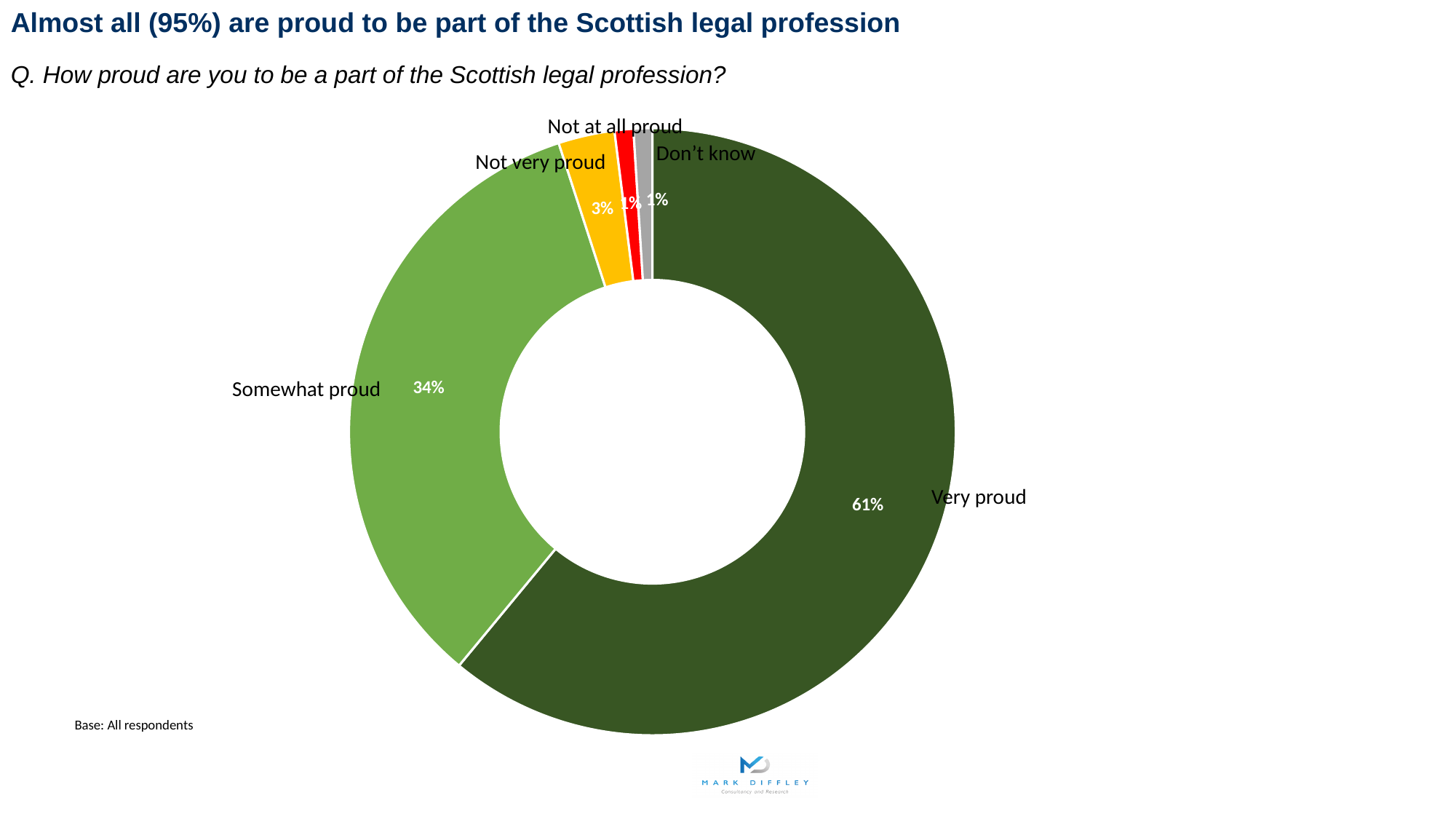
What percentage of respondents said they are very proud to be part of the Scottish legal profession? 61% Which response category has the largest share of the chart? Very proud What is the survey question shown above the chart? How proud are you to be a part of the Scottish legal profession? What percentage of respondents said they are not very proud? 3% Which is larger, the share for 'Somewhat proud' or the share for 'Not very proud'? Somewhat proud What kind of chart is shown on the slide? Doughnut (pie) chart What is the difference in percentage points between 'Very proud' and 'Somewhat proud'? 27 What is the combined share of 'Very proud' and 'Somewhat proud'? 95% What colour is the 'Not very proud' segment? Yellow/orange How many response categories are shown in the chart? 5 What percentage of respondents said they are somewhat proud? 34% What percentage of respondents answered 'Don't know'? 1%